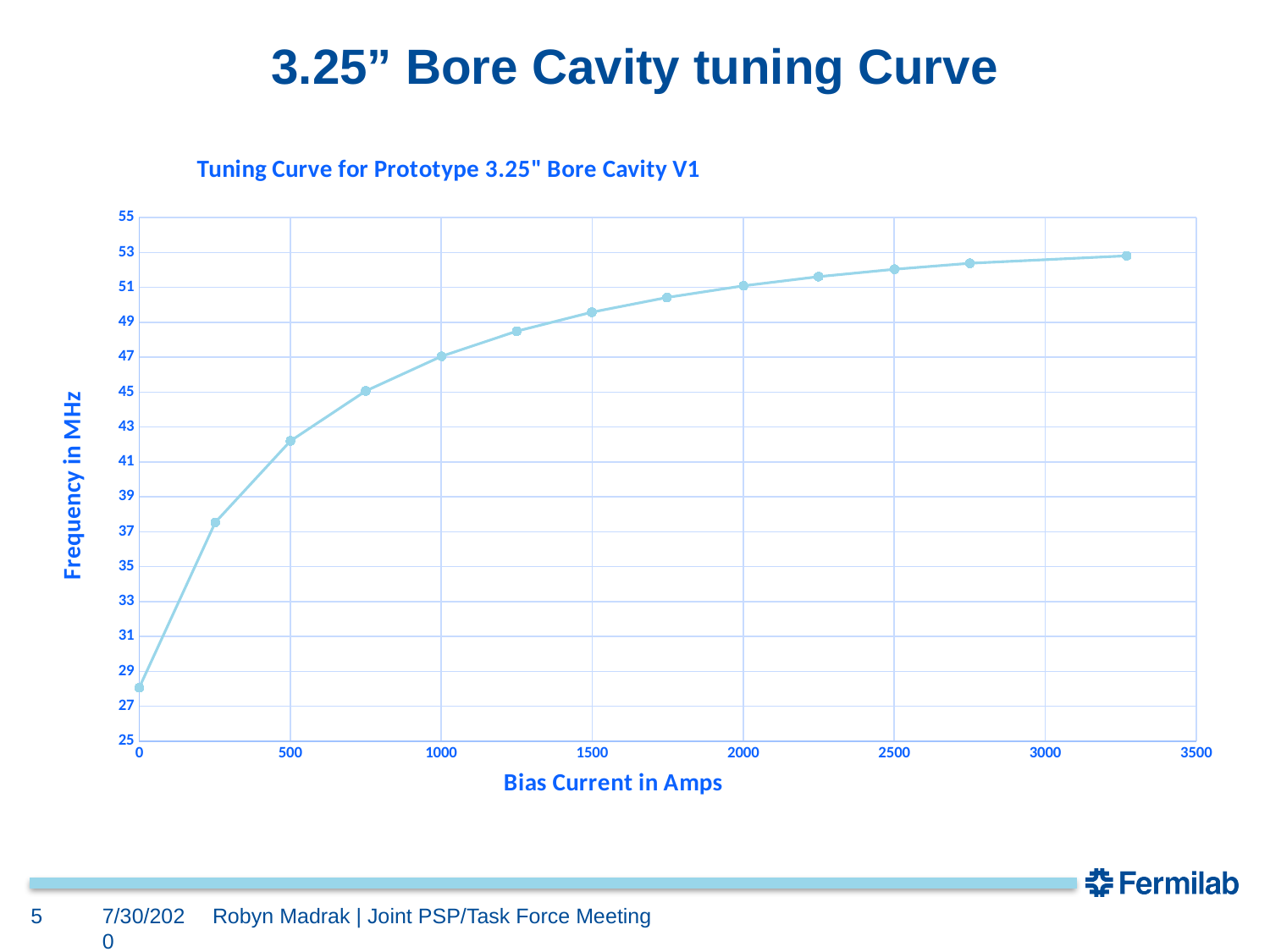
What kind of chart is shown on the slide? line chart How many data points are plotted on the curve? 13 Is the frequency at a bias current of 250 Amps greater or less than 39 MHz? less At which bias current is the frequency lowest? 0 Amps What is the title of the chart? Tuning Curve for Prototype 3.25" Bore Cavity V1 What is the label of the y axis? Frequency in MHz Which has the higher frequency: a bias current of 500 Amps or 1000 Amps? 1000 Amps Is the frequency at a bias current of 2500 Amps greater or less than 53 MHz? less Is the frequency at a bias current of 0 Amps greater or less than 31 MHz? less Does the frequency rise or fall as the bias current increases along the x axis? rise